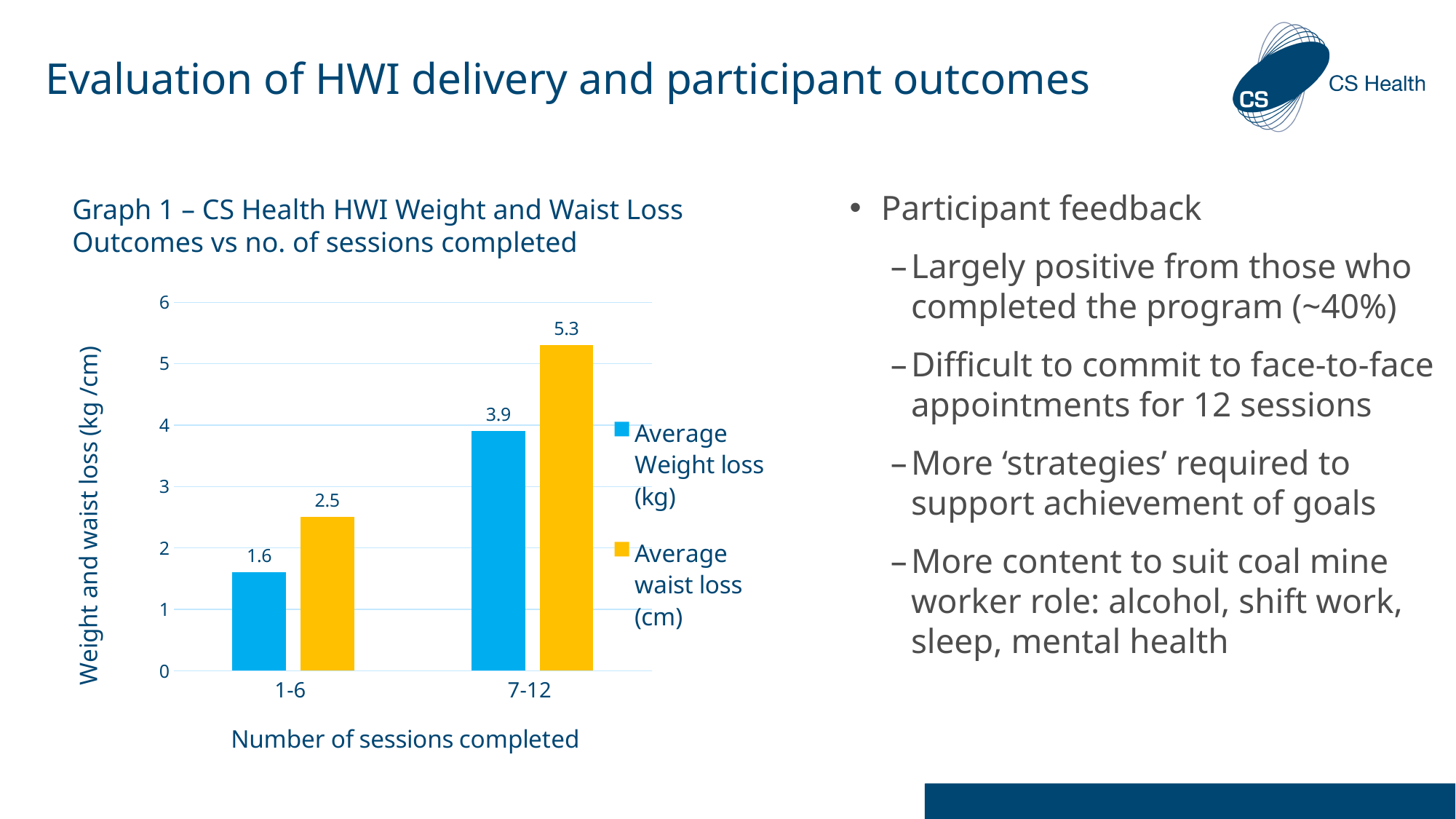
What is the average waist loss (cm) for the 1-6 sessions group? 2.5 What is the average weight loss (kg) for the 7-12 sessions group? 3.9 How many series does the legend list? 2 Which session group has the lowest average weight loss (kg)? 1-6 What is the label of the x axis of the chart? Number of sessions completed For the 7-12 sessions group, which is larger: average weight loss (kg) or average waist loss (cm)? Average waist loss (cm) What is the difference in average waist loss (cm) between the 7-12 and 1-6 session groups? 2.8 What is the difference in average weight loss (kg) between the 7-12 and 1-6 session groups? 2.3 What is the average weight loss (kg) for participants who completed 1-6 sessions? 1.6 Which session group has the highest average waist loss (cm)? 7-12 What is the average waist loss (cm) for participants who completed 7-12 sessions? 5.3 What kind of chart is shown on the slide? Bar chart